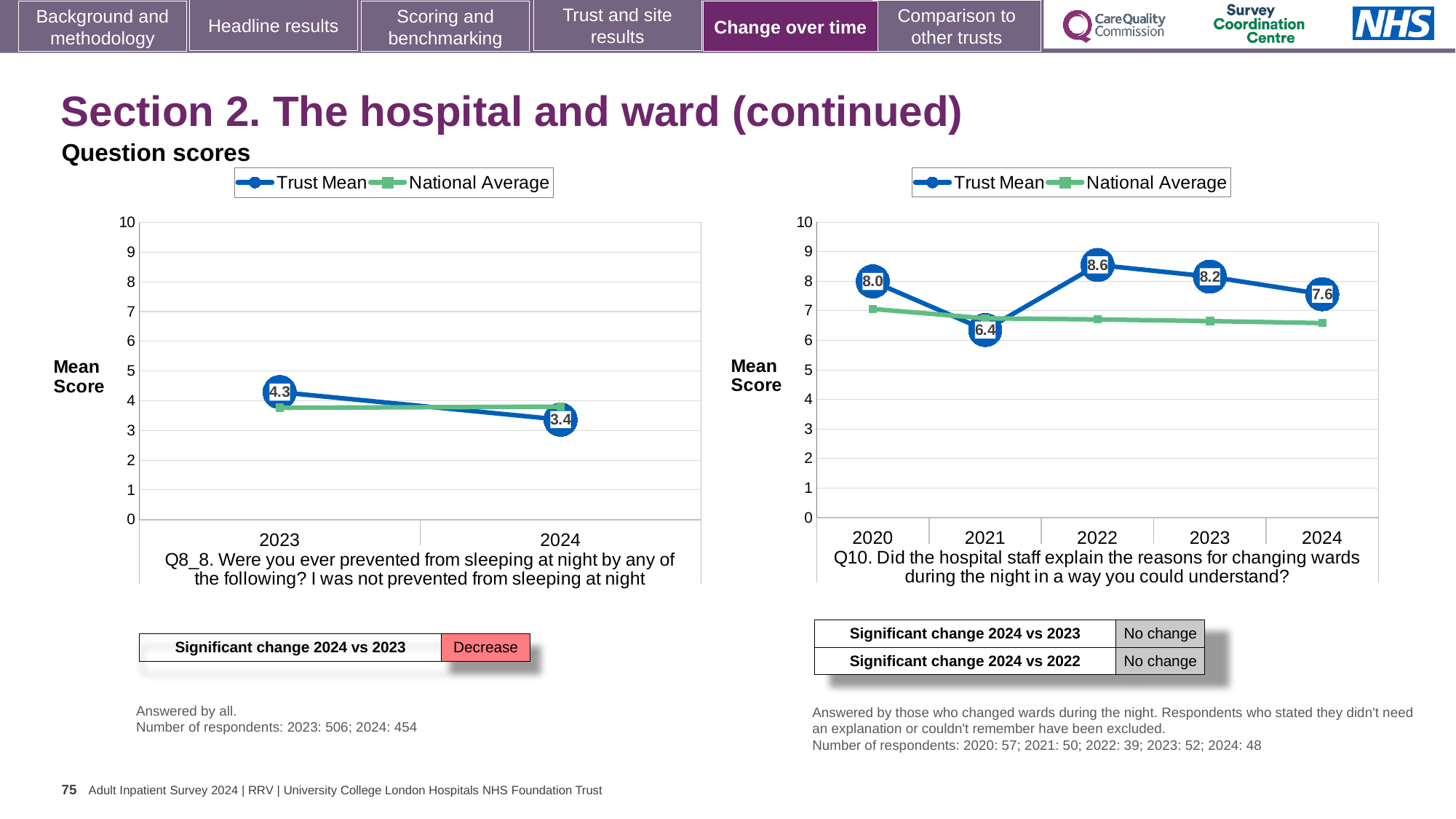
In the Q10 chart on the right, which year has the lowest Trust Mean score? 2021 What type of chart is used for the Q10 chart on the right? line chart In the Q10 chart on the right, how many years are plotted on the x axis? 5 In the Q10 chart on the right, what is the difference between the Trust Mean in 2022 and in 2021? 2.2 In the Q10 chart on the right, is the Trust Mean higher in 2020 or in 2024? 2020 In the Q8_8 chart on the left, does the Trust Mean rise or fall from 2023 to 2024? fall In the Q8_8 chart on the left, by how much did the Trust Mean fall from 2023 to 2024? 0.9 In the Q10 chart on the right, what is the Trust Mean score for 2022? 8.6 In the Q8_8 chart on the left, is the National Average for 2023 greater or less than 4? less In the Q10 chart on the right, which year has the highest Trust Mean score? 2022 In the Q8_8 chart on the left, what is the Trust Mean score for 2023? 4.3 In the Q8_8 chart on the left, what is the Trust Mean score for 2024? 3.4